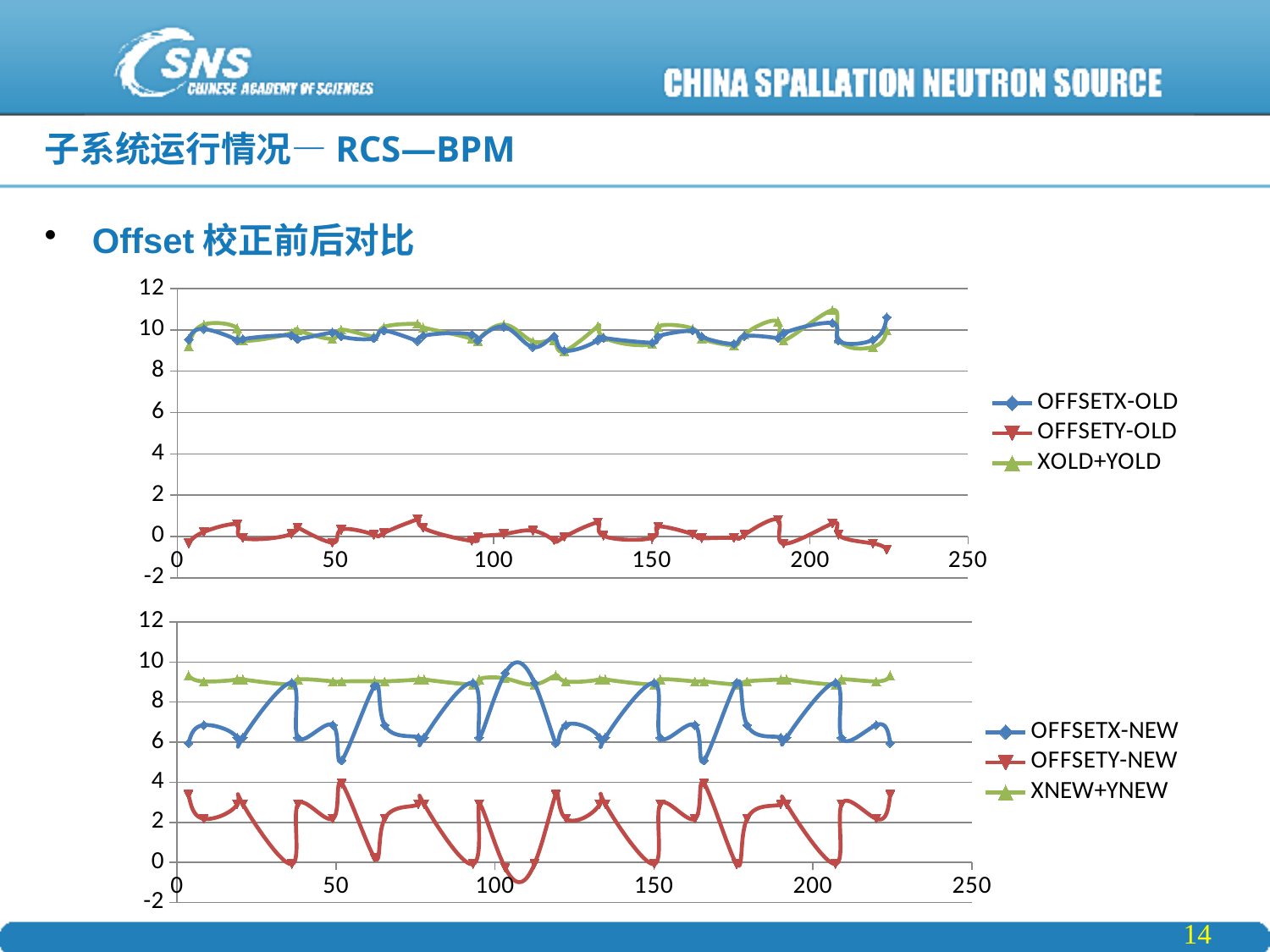
How many series does the legend of the top chart list? 3 In the bottom chart, are the values of the OFFSETY-NEW series greater or less than 6? less In the top chart, what colour is the OFFSETY-OLD series line? red What kind of chart is the bottom chart on the slide? line chart In the top chart, which series has larger values overall, OFFSETX-OLD or OFFSETY-OLD? OFFSETX-OLD In the top chart, are the values of the OFFSETY-OLD series greater or less than 2? less In the top chart, are the values of the OFFSETX-OLD series greater or less than 8? greater In the bottom chart, which series has larger values overall, XNEW+YNEW or OFFSETY-NEW? XNEW+YNEW What is the highest value shown on the y axis of the bottom chart? 12 How many series does the legend of the bottom chart list? 3 What kind of chart is the top chart on the slide? line chart